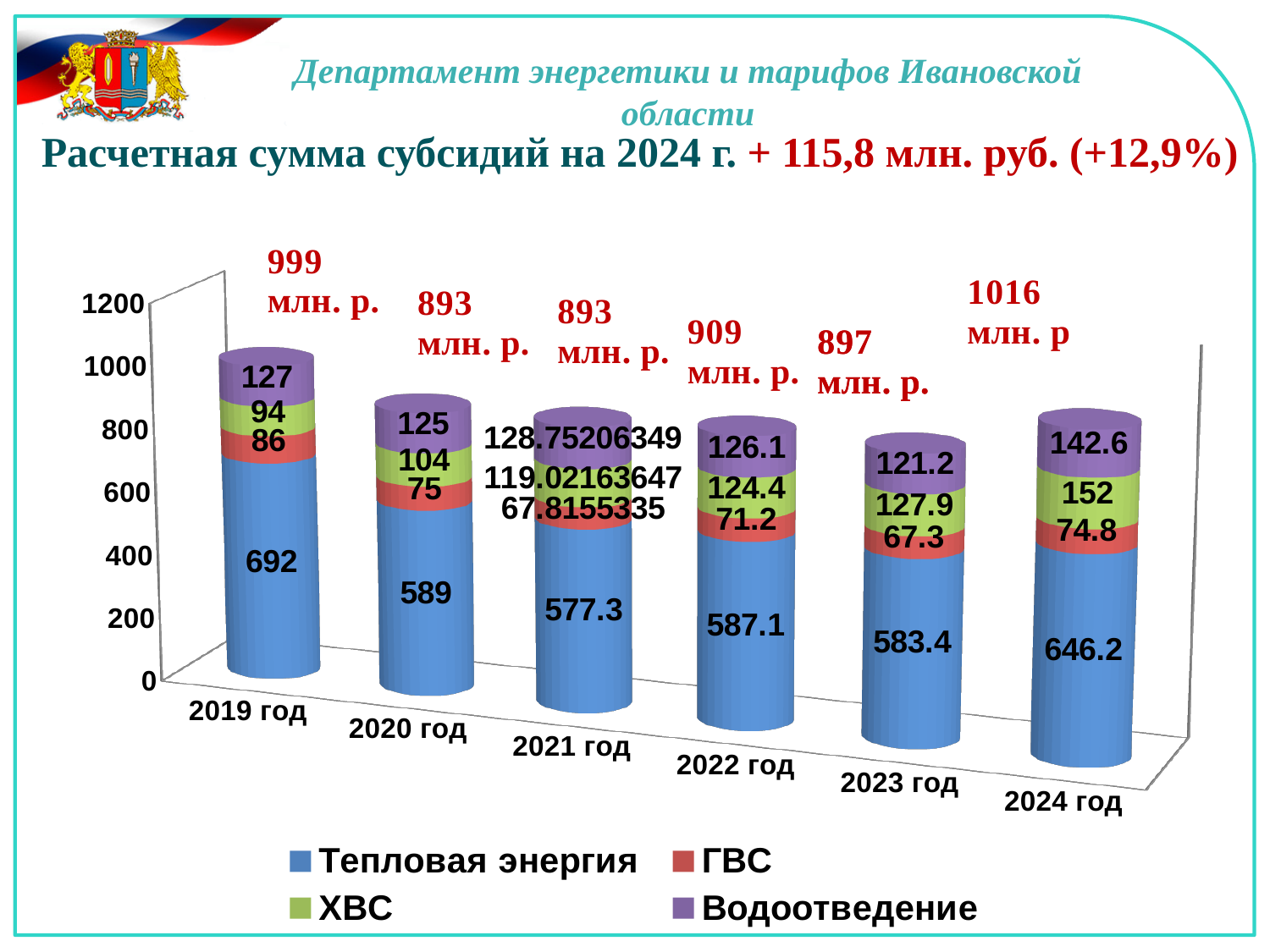
How many series does the legend list? 4 What is the total of the stacked bar for 2019 год? 999 What is the value of ГВС for 2019 год? 86 What type of chart is shown on the slide? stacked bar chart What is the value of Тепловая энергия for 2024 год? 646.2 What is the difference between Тепловая энергия in 2024 год and 2023 год? 62.8 How many years are shown along the x axis? 6 Which year has the larger Водоотведение value, 2019 год or 2024 год? 2024 год What total is annotated in red above the 2024 год bar? 1016 млн. р What is the value of Водоотведение for 2022 год? 126.1 In which year is ХВС the highest? 2024 год In which year is Тепловая энергия the highest? 2019 год